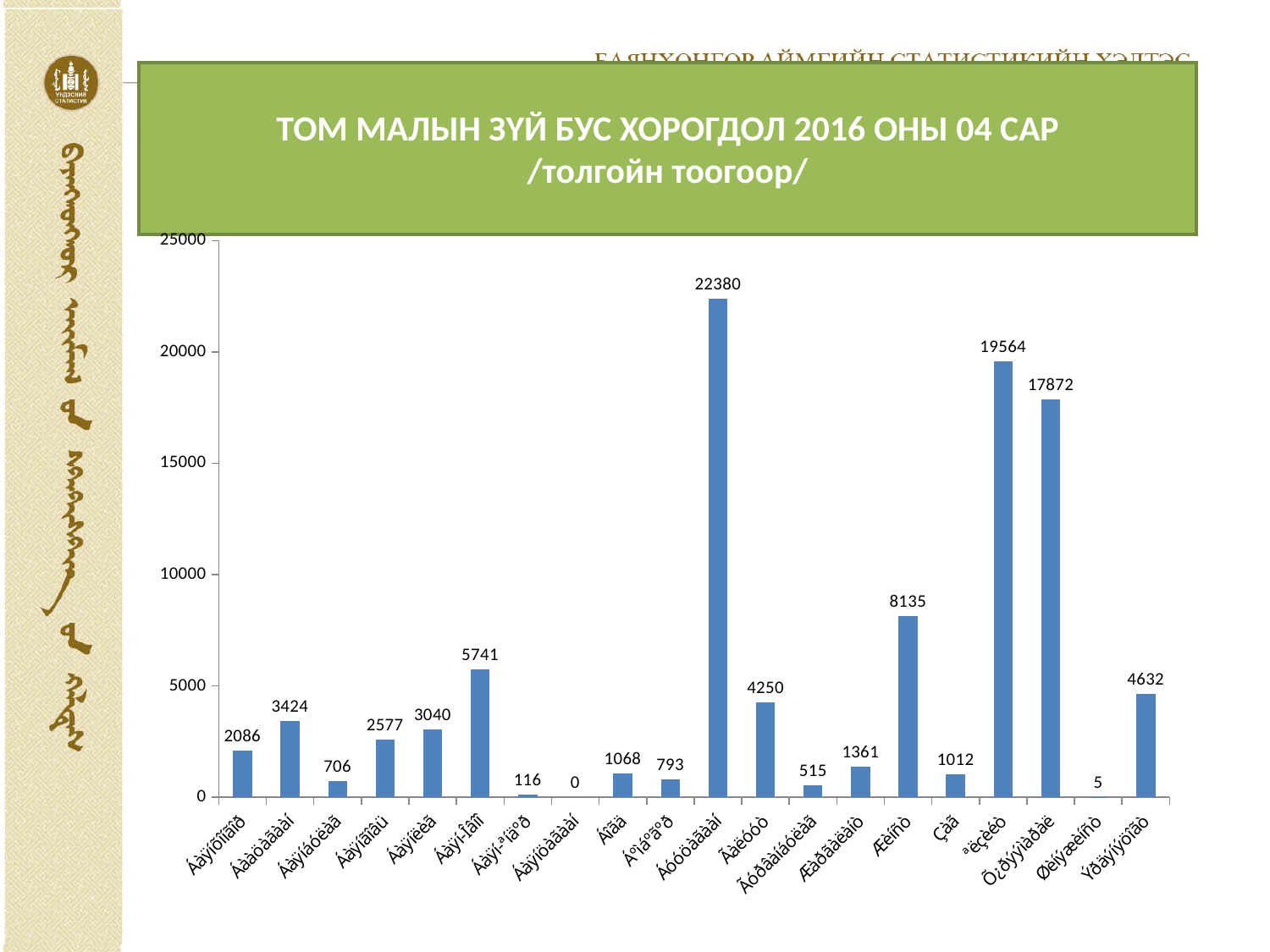
What is the lowest value shown in the chart? 0 What is the difference between the highest value (22380) and the second highest value (19564)? 2816 What is the value of the last (rightmost) bar in the chart? 4632 What is the highest value shown in the chart? 22380 What is the value of the first (leftmost) bar in the chart? 2086 Which is larger, the value of the first bar (2086) or the second bar (3424)? 3424 What is the difference between the second bar (3424) and the first bar (2086)? 1338 What is the title of the chart? ТОМ МАЛЫН ЗҮЙ БУС ХОРОГДОЛ 2016 ОНЫ 04 САР /толгойн тоогоор/ What is the maximum value shown on the vertical axis? 25000 Is the value of the tallest bar greater or less than 20000? greater What type of chart is shown on the slide? bar chart How many bars (categories) are plotted in the chart? 20